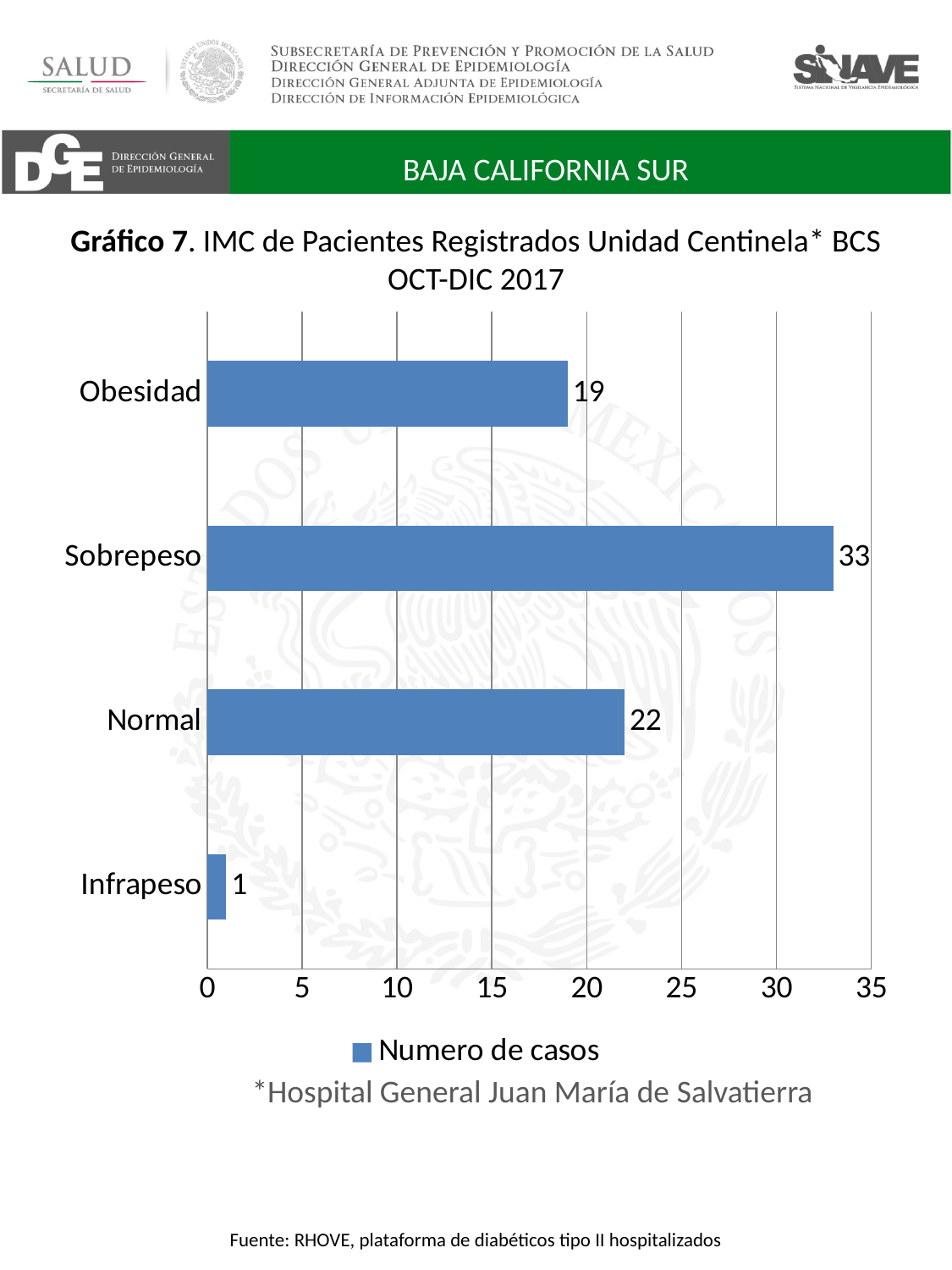
What is the value for Obesidad? 19 Which is larger, the value for Normal or the value for Obesidad? Normal What is the value for Infrapeso? 1 Which category has the highest number of cases? Sobrepeso Which category has the lowest number of cases? Infrapeso What is the value for Normal? 22 How many categories are shown on the chart? 4 What is the value for Sobrepeso? 33 What series name does the legend show? Numero de casos Is the value for Sobrepeso greater or less than 30? greater What is the difference between the values for Sobrepeso and Obesidad? 14 What kind of chart is shown on the slide? bar chart